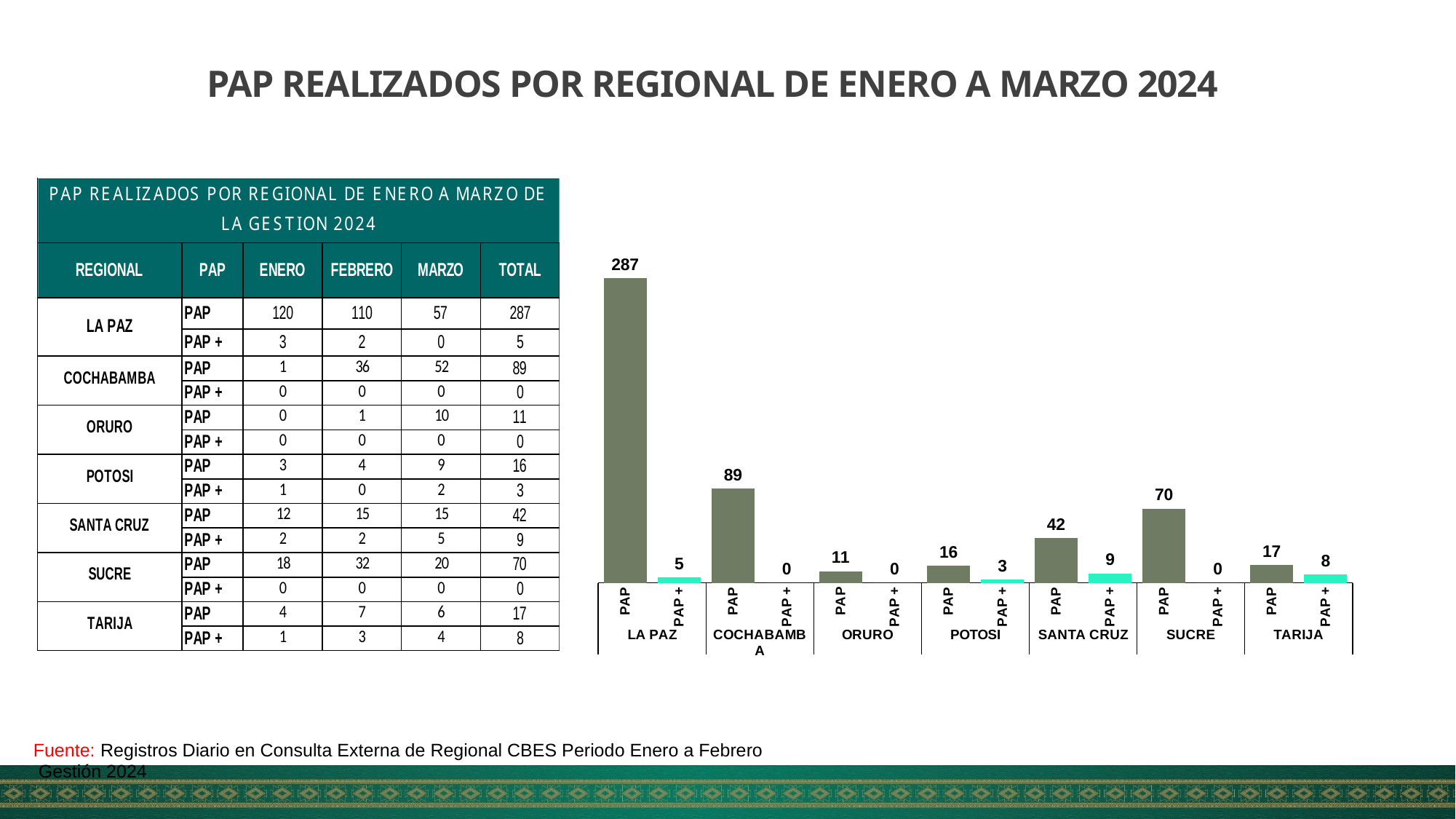
How many regionals are shown on the x axis of the chart? 7 What is the PAP + value for SANTA CRUZ in the chart? 9 What is the PAP + value for COCHABAMBA in the chart? 0 What is the difference between the PAP values for LA PAZ and COCHABAMBA? 198 Which regional has the highest PAP value in the chart? LA PAZ Which regional has the lowest PAP value in the chart? ORURO Which is larger in the chart, the PAP value for SANTA CRUZ or the PAP value for TARIJA? SANTA CRUZ What kind of chart is shown on the slide? bar chart What is the title of the slide? PAP REALIZADOS POR REGIONAL DE ENERO A MARZO 2024 What is the difference between the PAP and PAP + values for TARIJA in the chart? 9 What is the PAP value for LA PAZ in the chart? 287 What is the PAP value for SUCRE in the chart? 70